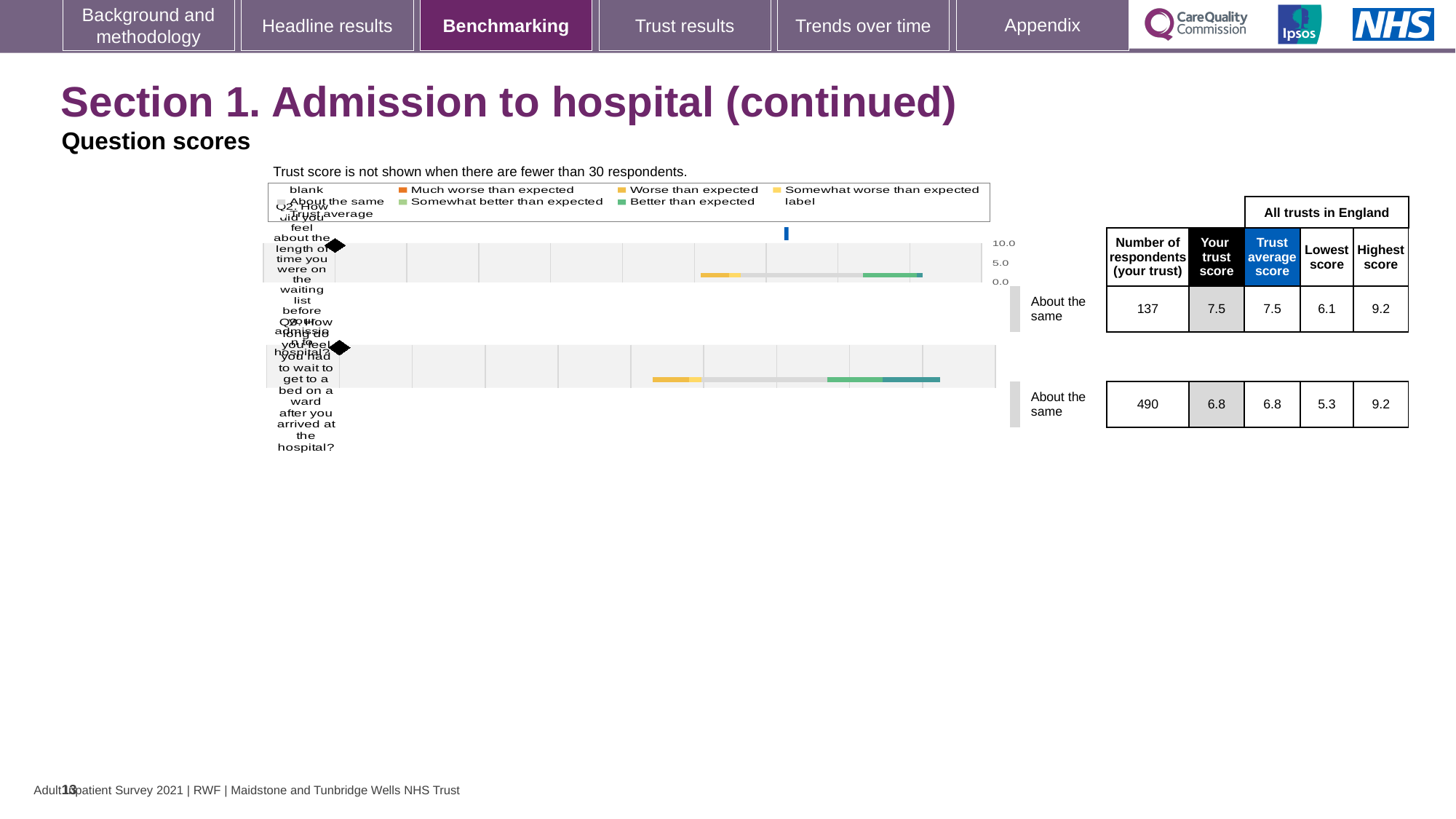
What is the trust score for Q3 (how long did you have to wait to get to a bed on a ward)? 6.8 What is the difference in the number of respondents between Q3 and Q2? 353 How is the trust's result for Q3 categorised relative to expectations? About the same Which question has the higher trust score, Q2 or Q3? Q2 What is the trust score for Q2 (how did you feel about the length of time on the waiting list)? 7.5 How many respondents answered Q3 at the trust? 490 How many respondents answered Q2 at the trust? 137 What is the highest score across all trusts in England for Q2? 9.2 What kind of chart is shown on the slide? bar chart How many questions (categories) are plotted in the chart? 2 What is the difference between the trust scores for Q2 and Q3? 0.7 What is the lowest score across all trusts in England for Q3? 5.3